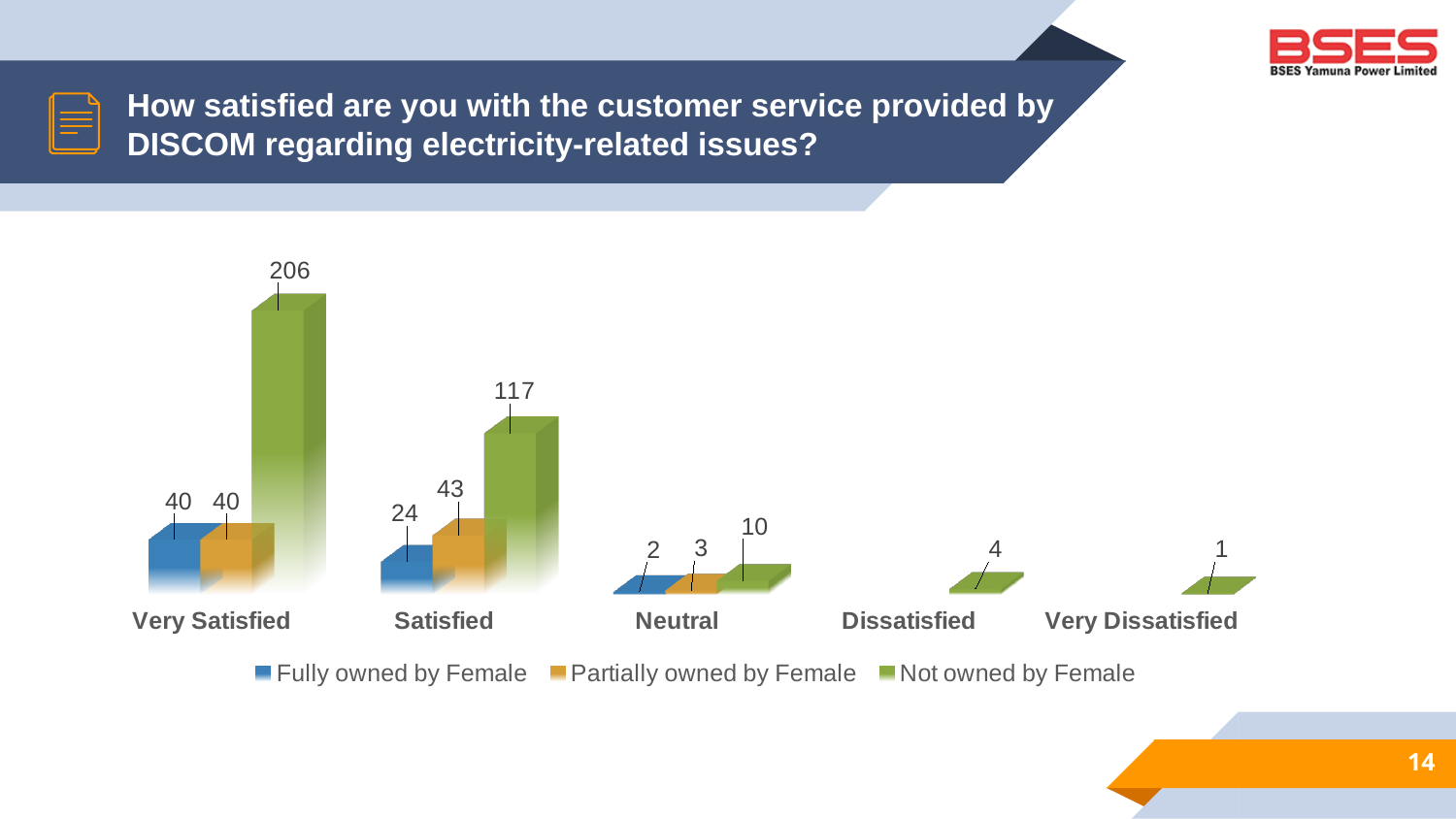
What is the value for Partially owned by Female in the Satisfied category? 43 What is the difference between the Not owned by Female values for Very Satisfied and Satisfied? 89 Which category has the highest value for Not owned by Female? Very Satisfied How many series does the legend list? 3 What is the value for Not owned by Female in the Dissatisfied category? 4 What is the value for Fully owned by Female in the Neutral category? 2 Which is larger in the Satisfied category: Fully owned by Female or Partially owned by Female? Partially owned by Female Which category has the lowest value for Not owned by Female? Very Dissatisfied Which series is shown in green in the legend? Not owned by Female What kind of chart is shown on the slide? Bar chart How many satisfaction categories are shown on the x axis? 5 What is the value for Not owned by Female in the Very Satisfied category? 206